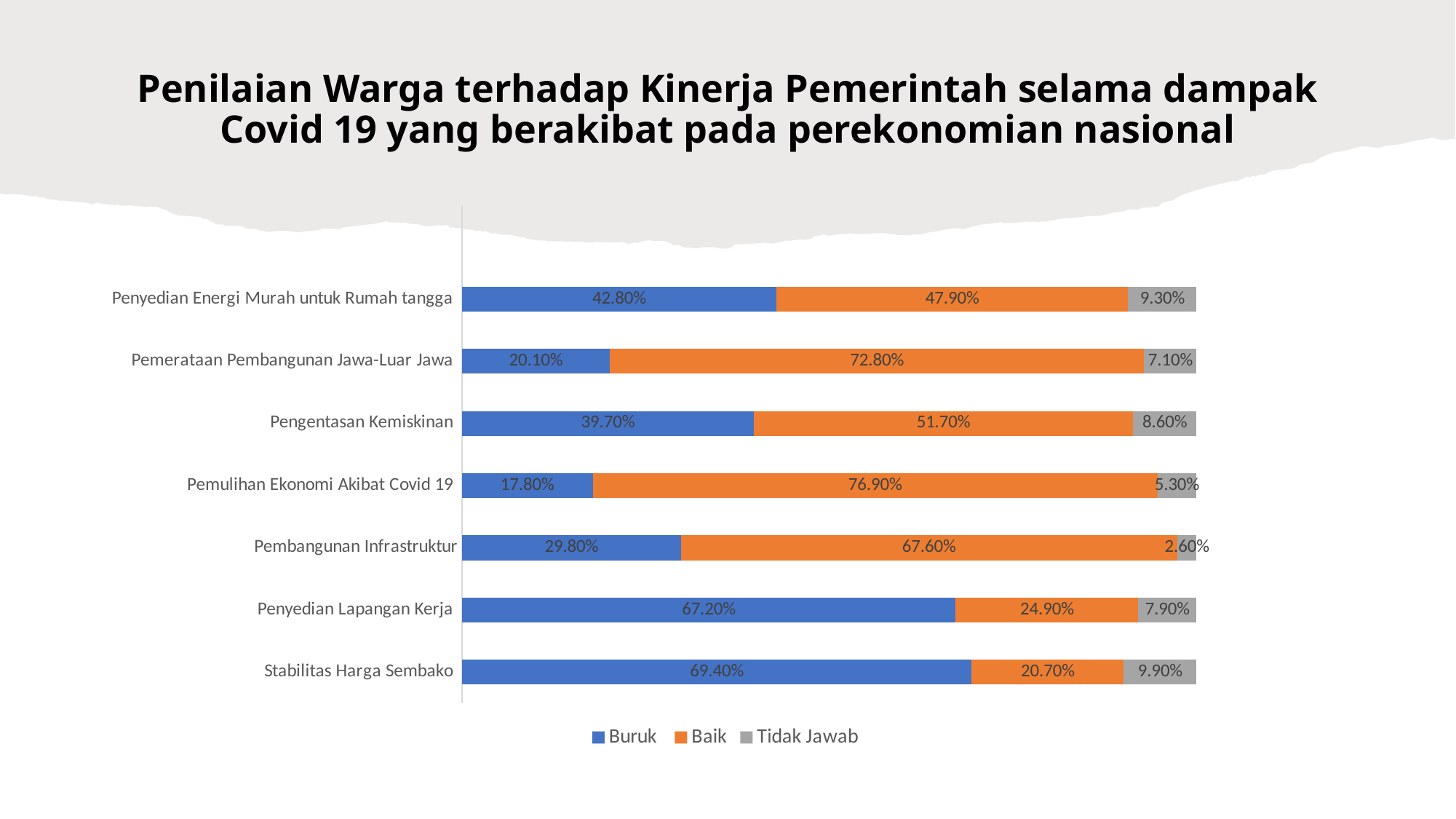
What is the total of the stacked bar for Pembangunan Infrastruktur? 100.00% For Pemerataan Pembangunan Jawa-Luar Jawa, what is the difference between the Baik and Buruk values? 52.70% Which category has the lowest Tidak Jawab value? Pembangunan Infrastruktur How many categories are plotted on the chart? 7 Which category has the highest Buruk value? Stabilitas Harga Sembako What is the Tidak Jawab value for Pengentasan Kemiskinan? 8.60% Which category has the highest Baik value? Pemulihan Ekonomi Akibat Covid 19 What is the Buruk value for Stabilitas Harga Sembako? 69.40% What type of chart is shown on the slide? Stacked bar chart How many series does the legend list? 3 For Penyedian Energi Murah untuk Rumah tangga, which is larger: the Buruk value or the Baik value? Baik What is the Baik value for Pemulihan Ekonomi Akibat Covid 19? 76.90%